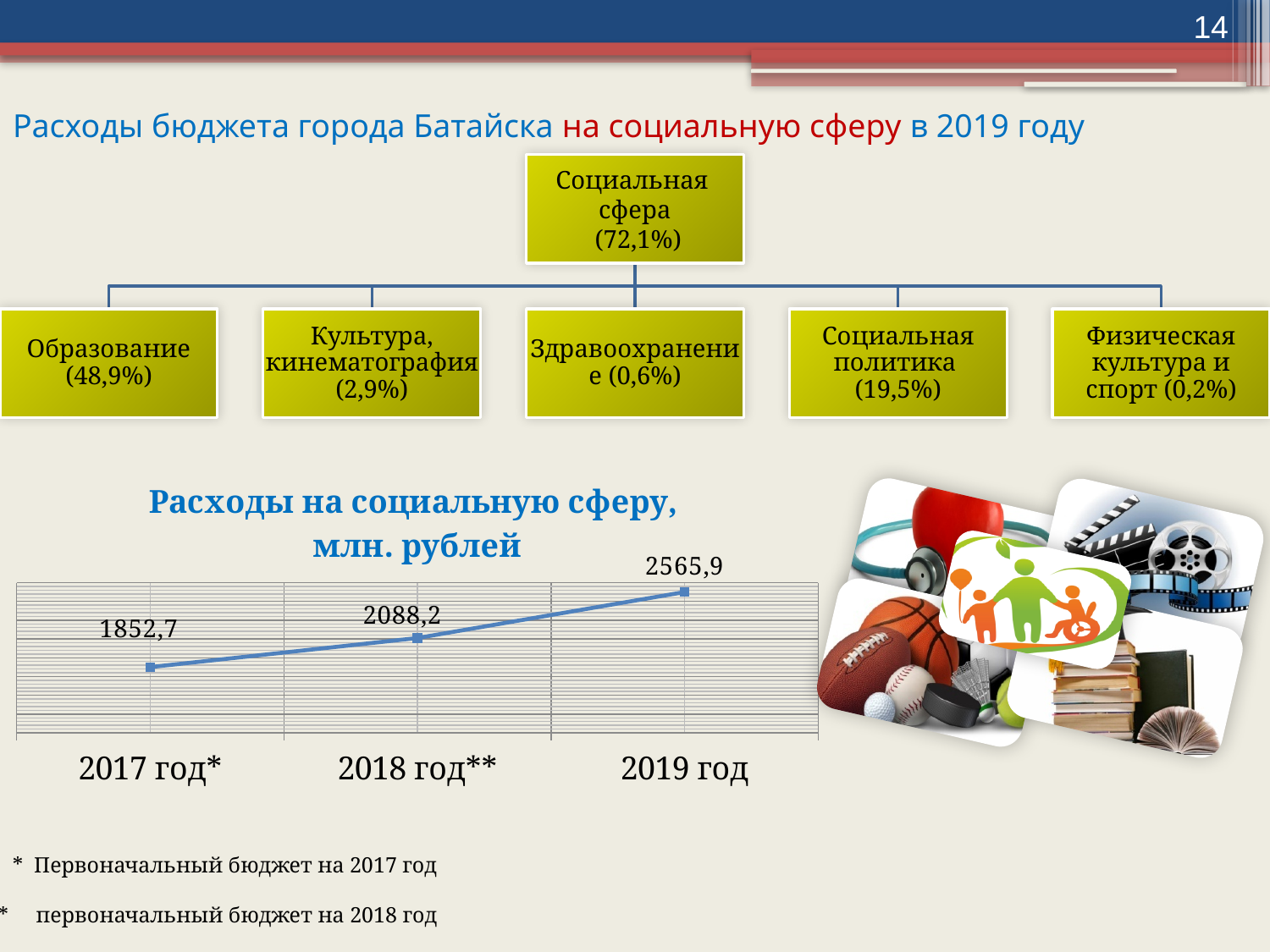
What unit is stated in the title of the line chart on the slide? млн. рублей What type of chart is "Расходы на социальную сферу, млн. рублей"? line chart In the chart "Расходы на социальную сферу, млн. рублей", what is the value for 2019 год? 2565,9 In the chart "Расходы на социальную сферу, млн. рублей", what is the difference between the values for 2018 год** and 2017 год*? 235,5 In the chart "Расходы на социальную сферу, млн. рублей", what is the value for 2018 год**? 2088,2 In the chart "Расходы на социальную сферу, млн. рублей", do the values rise or fall from 2017 to 2019? rise In the chart "Расходы на социальную сферу, млн. рублей", what is the difference between the values for 2019 год and 2017 год*? 713,2 In the chart "Расходы на социальную сферу, млн. рублей", which year has the highest value? 2019 год In the chart "Расходы на социальную сферу, млн. рублей", which is larger: the value for 2018 год** or 2019 год? 2019 год How many data points are plotted in the chart "Расходы на социальную сферу, млн. рублей"? 3 In the chart "Расходы на социальную сферу, млн. рублей", which year has the lowest value? 2017 год* In the chart "Расходы на социальную сферу, млн. рублей", what is the value for 2017 год*? 1852,7